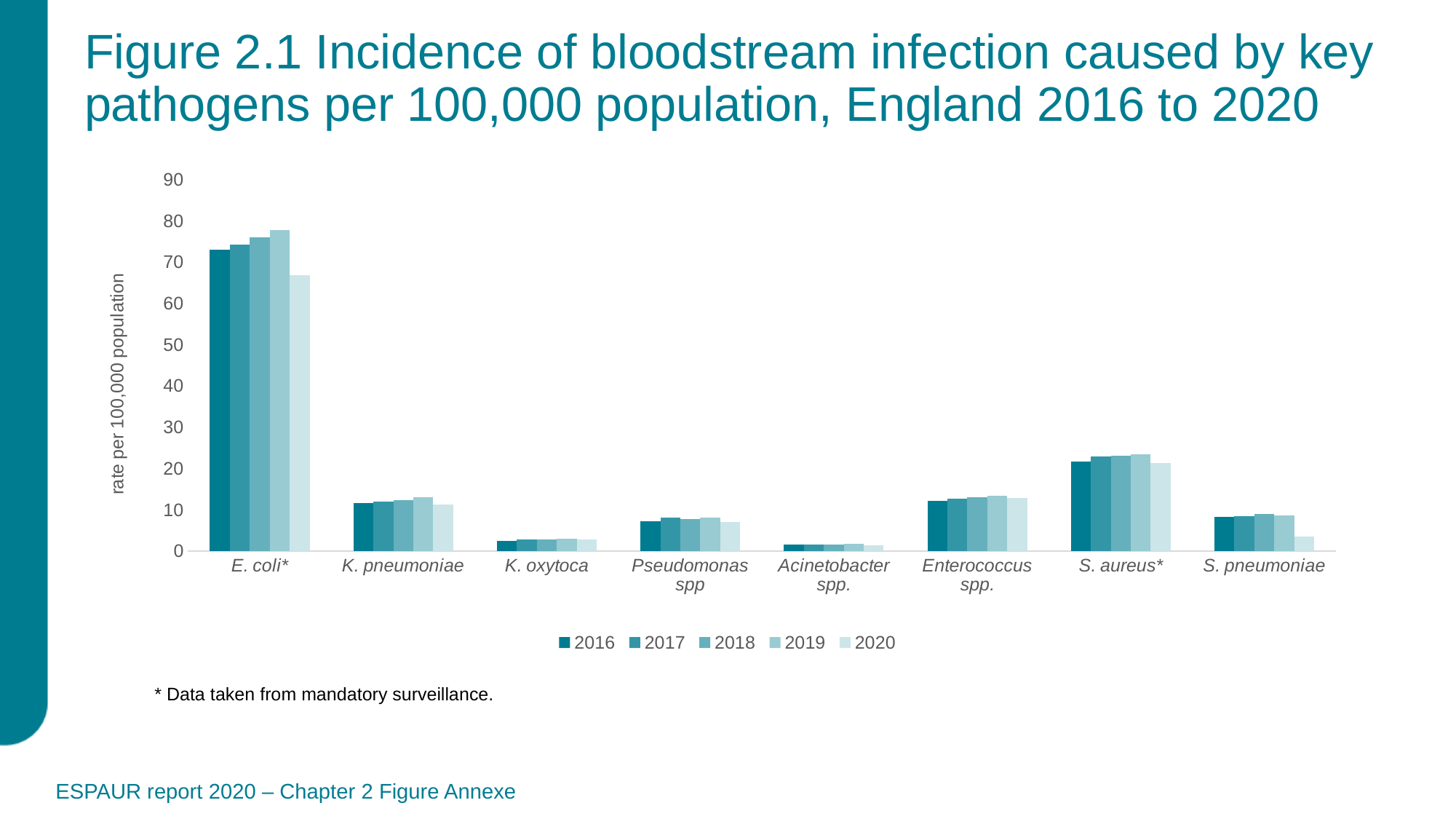
In 2016, which pathogen has the larger value, S. aureus* or Enterococcus spp.? S. aureus* Is the 2020 value for E. coli* greater or less than 70? less For E. coli*, which year has the larger value, 2019 or 2020? 2019 Is the 2019 value for K. pneumoniae greater or less than 10? greater Is the 2019 value for E. coli* greater or less than 70? greater What is the label of the y axis? rate per 100,000 population Which pathogen has the highest incidence of bloodstream infection? E. coli* Which pathogen has the lowest incidence of bloodstream infection? Acinetobacter spp. How many pathogen categories are shown on the x axis? 8 What kind of chart is shown on the slide? bar chart How many series (years) does the legend list? 5